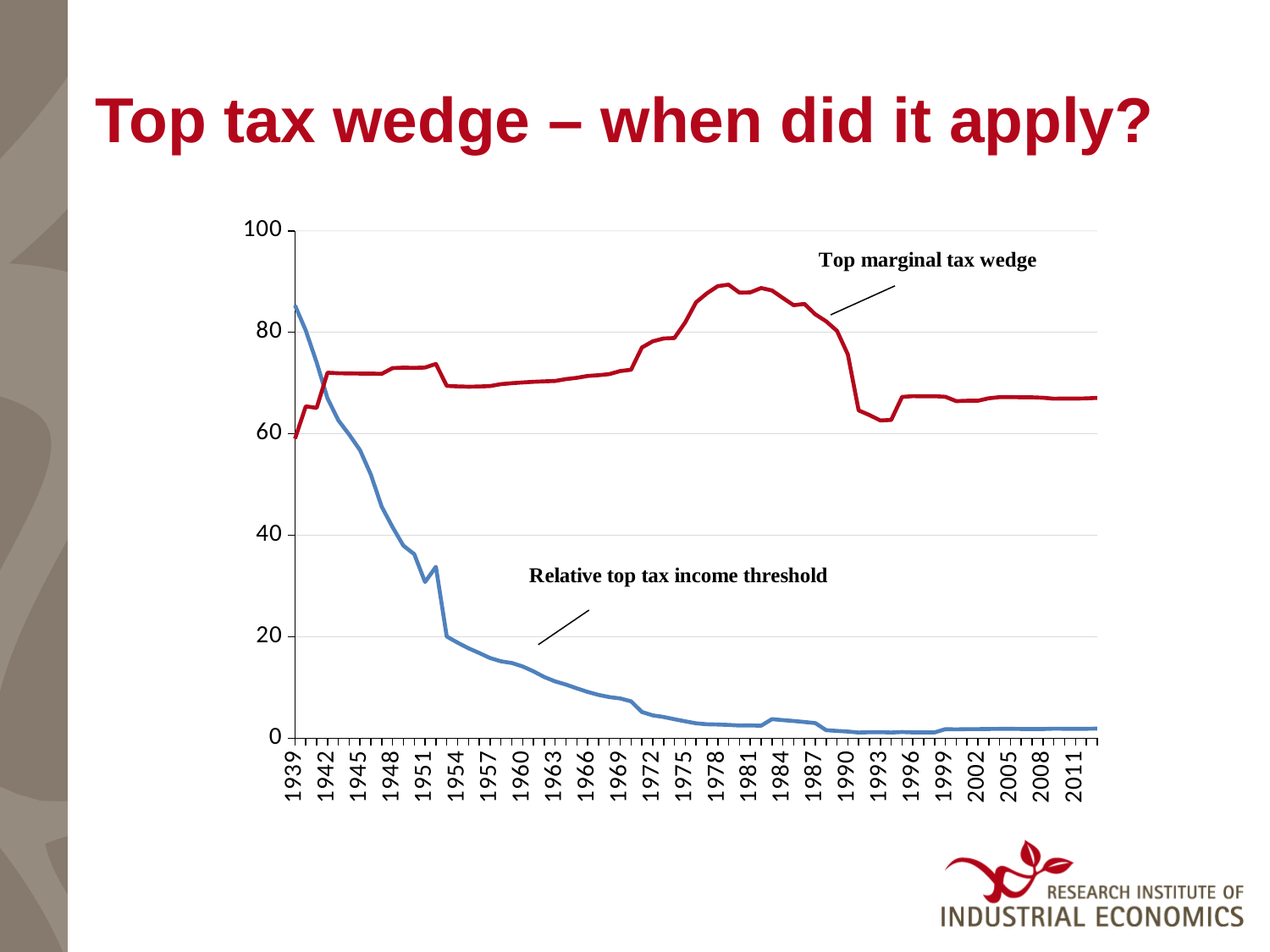
How many series are plotted on the chart? 2 Does the Relative top tax income threshold rise or fall over the period from 1939 to 2011? fall In 2011, which series has the higher value, Top marginal tax wedge or Relative top tax income threshold? Top marginal tax wedge Does the Top marginal tax wedge rise or fall between 1972 and 1978? rise Which series is drawn in blue? Relative top tax income threshold What is the title of the slide containing the chart? Top tax wedge – when did it apply? In 1939, which series has the higher value, Top marginal tax wedge or Relative top tax income threshold? Relative top tax income threshold Is the value of the Top marginal tax wedge in 1981 greater or less than 80? greater Is the value of the Relative top tax income threshold in 1939 greater or less than 80? greater Is the value of the Relative top tax income threshold in 1960 greater or less than 20? less What kind of chart is shown on the slide? line chart Does the Top marginal tax wedge rise or fall between 1987 and 1990? fall